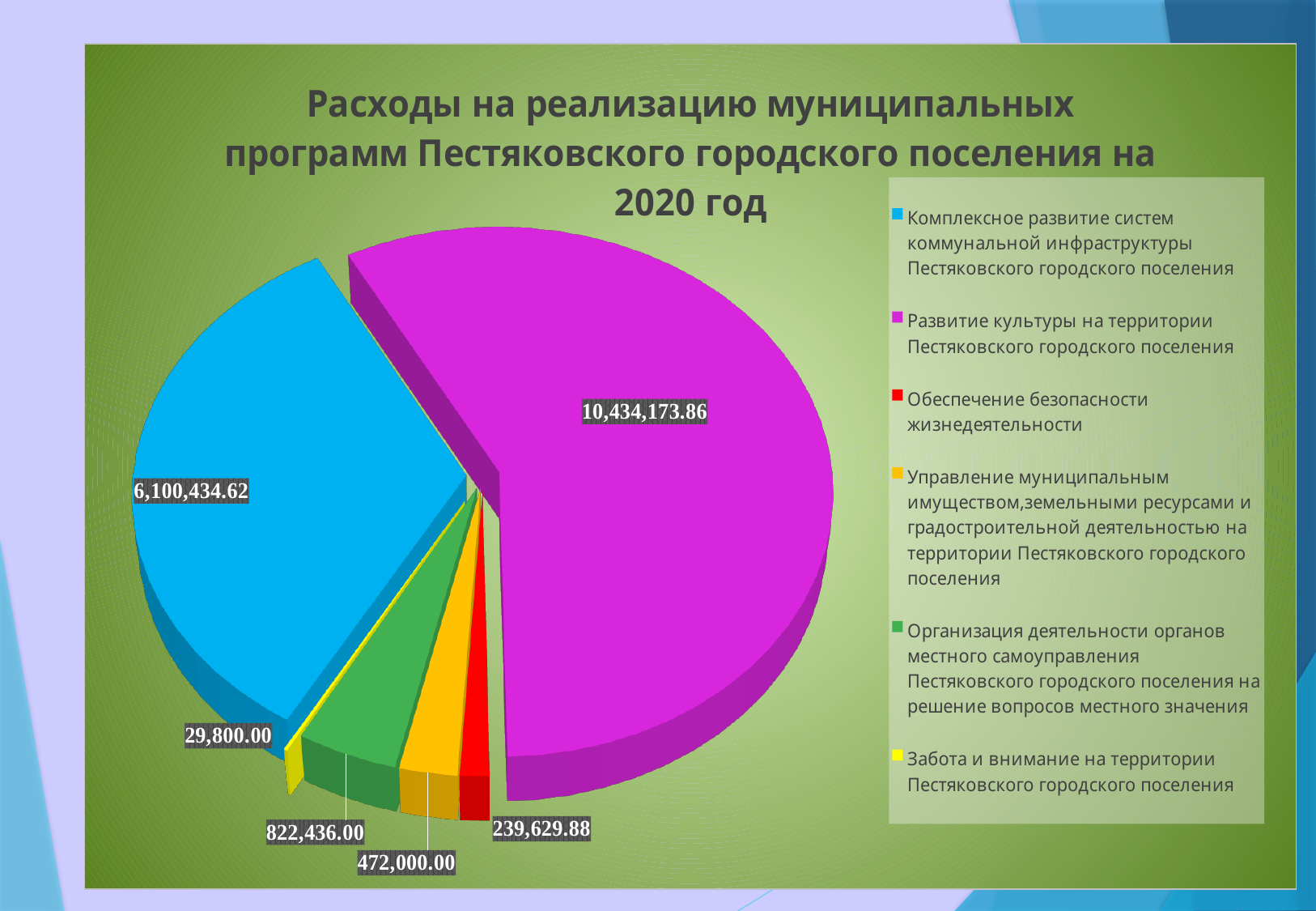
How many categories does the legend list? 6 What type of chart is shown on the slide? Pie chart What is the value for "Комплексное развитие систем коммунальной инфраструктуры Пестяковского городского поселения"? 6,100,434.62 What is the value for "Организация деятельности органов местного самоуправления Пестяковского городского поселения на решение вопросов местного значения"? 822,436.00 What is the value for "Развитие культуры на территории Пестяковского городского поселения"? 10,434,173.86 Which category has the smallest slice of the pie? Забота и внимание на территории Пестяковского городского поселения Which is larger: the value for "Управление муниципальным имуществом..." or the value for "Обеспечение безопасности жизнедеятельности"? Управление муниципальным имуществом... What colour is the slice for "Обеспечение безопасности жизнедеятельности"? Red What is the value for "Обеспечение безопасности жизнедеятельности"? 239,629.88 Which category has the largest slice of the pie? Развитие культуры на территории Пестяковского городского поселения What is the value for "Забота и внимание на территории Пестяковского городского поселения"? 29,800.00 What is the difference between the values for "Развитие культуры" and "Комплексное развитие систем коммунальной инфраструктуры"? 4,333,739.24